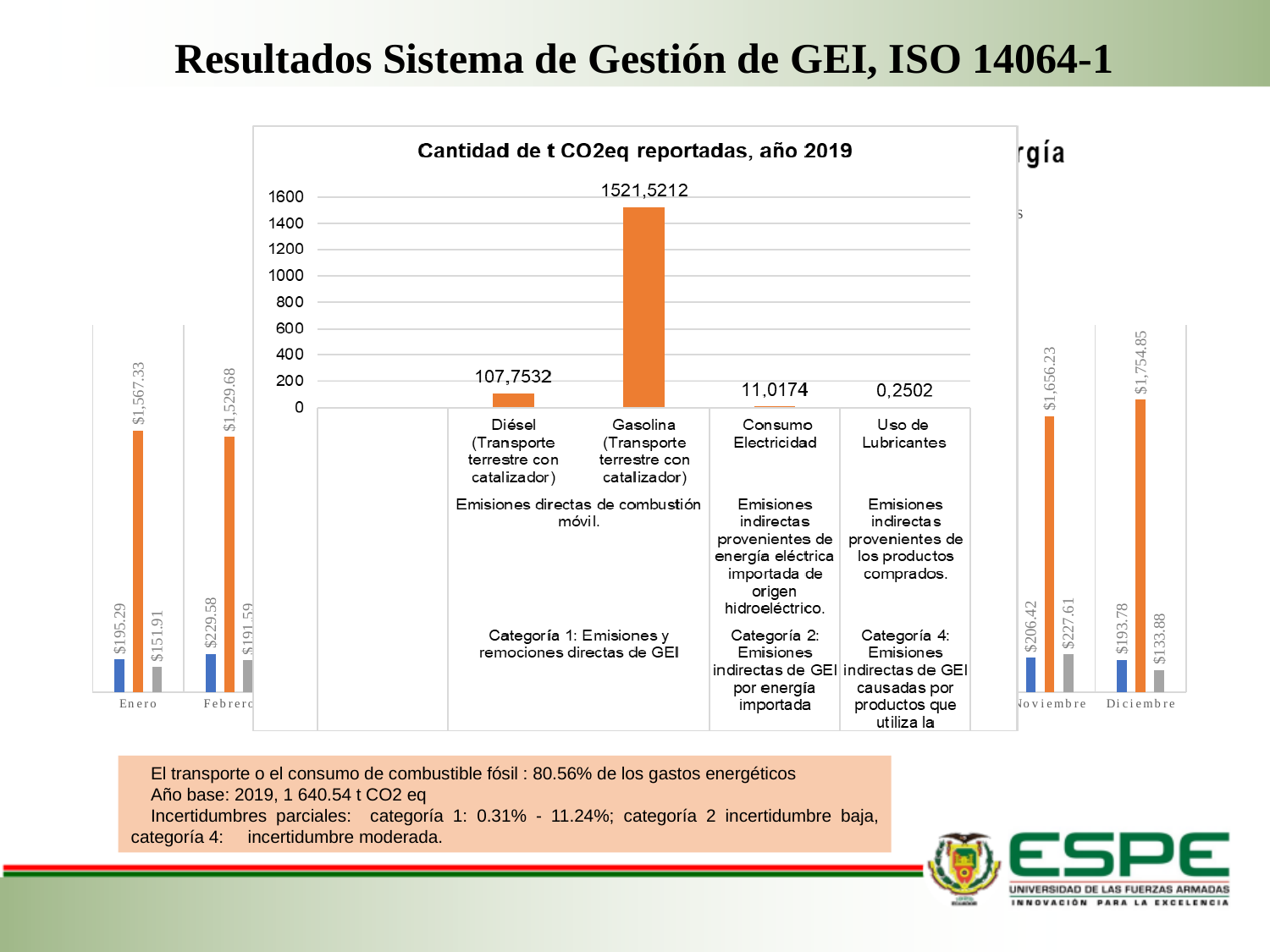
In the chart 'Cantidad de t CO2eq reportadas, año 2019', which category has the highest value? Gasolina (Transporte terrestre con catalizador) In the chart 'Cantidad de t CO2eq reportadas, año 2019', is the value for Gasolina greater or less than 1400? greater How many categories are plotted in the chart 'Cantidad de t CO2eq reportadas, año 2019'? 4 What kind of chart is 'Cantidad de t CO2eq reportadas, año 2019'? bar chart In the chart 'Cantidad de t CO2eq reportadas, año 2019', what is the value for Consumo Electricidad? 11,0174 In the partially hidden chart behind the main chart, what is the value of the orange bar for Diciembre? $1,754.85 In the chart 'Cantidad de t CO2eq reportadas, año 2019', what is the value for Diésel (Transporte terrestre con catalizador)? 107,7532 In the chart 'Cantidad de t CO2eq reportadas, año 2019', which is larger: the value for Diésel or the value for Consumo Electricidad? Diésel In the chart 'Cantidad de t CO2eq reportadas, año 2019', what is the difference between the Gasolina value and the Diésel value? 1413,768 In the chart 'Cantidad de t CO2eq reportadas, año 2019', what is the value for Uso de Lubricantes? 0,2502 In the chart 'Cantidad de t CO2eq reportadas, año 2019', what is the value for Gasolina (Transporte terrestre con catalizador)? 1521,5212 In the chart 'Cantidad de t CO2eq reportadas, año 2019', which category has the lowest value? Uso de Lubricantes